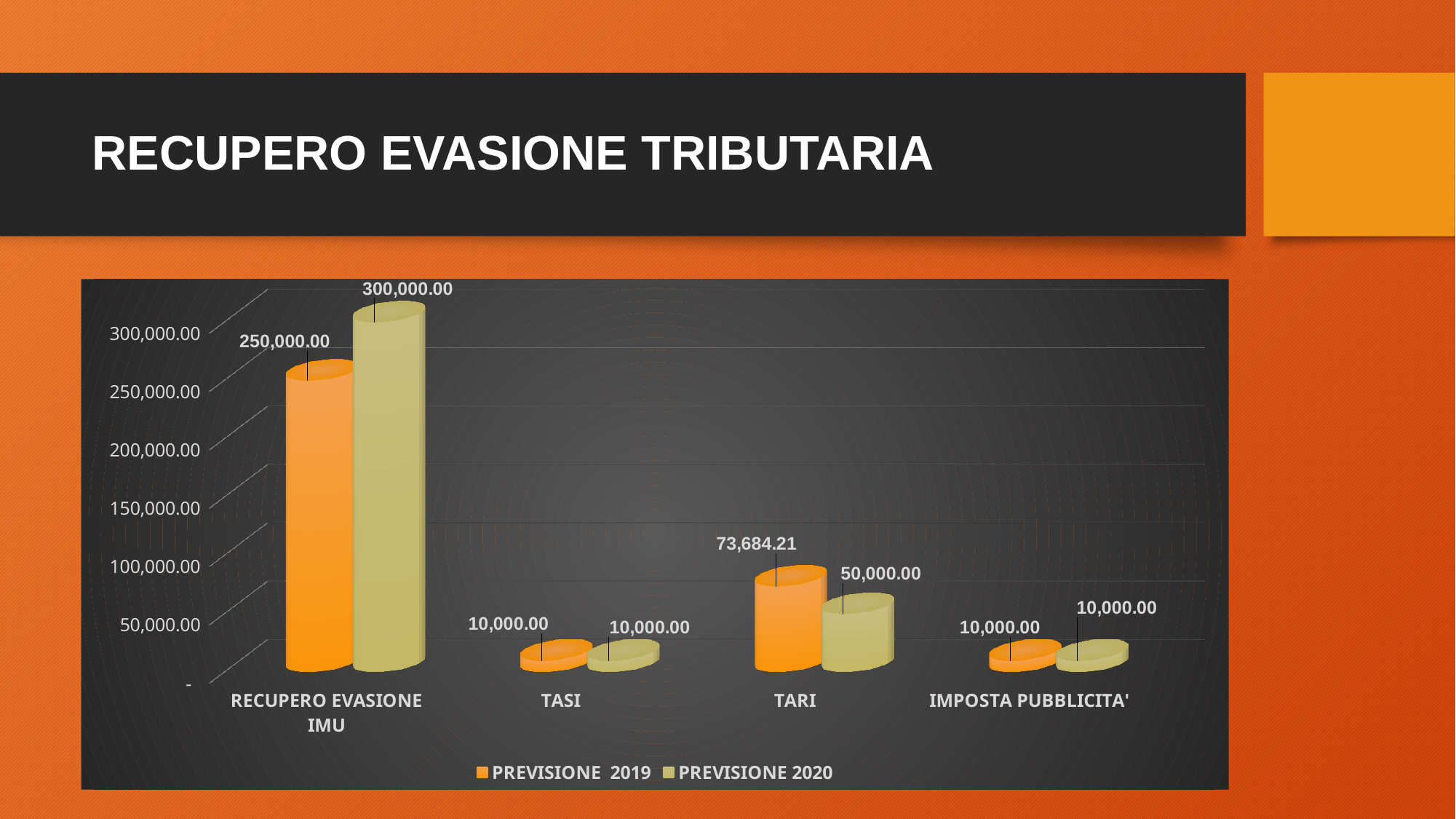
How many categories are shown on the x axis? 4 What is the difference between the PREVISIONE 2019 and PREVISIONE 2020 values for TARI? 23,684.21 For TARI, which is larger: PREVISIONE 2019 or PREVISIONE 2020? PREVISIONE 2019 What is the PREVISIONE 2019 value for TARI? 73,684.21 What is the PREVISIONE 2020 value for RECUPERO EVASIONE IMU? 300,000.00 What is the PREVISIONE 2020 value for IMPOSTA PUBBLICITA'? 10,000.00 What is the PREVISIONE 2020 value for TARI? 50,000.00 Which category has the highest PREVISIONE 2020 value? RECUPERO EVASIONE IMU What kind of chart is shown on the slide? Bar chart What is the difference between the PREVISIONE 2020 and PREVISIONE 2019 values for RECUPERO EVASIONE IMU? 50,000.00 How many series does the legend list? 2 What is the PREVISIONE 2019 value for RECUPERO EVASIONE IMU? 250,000.00